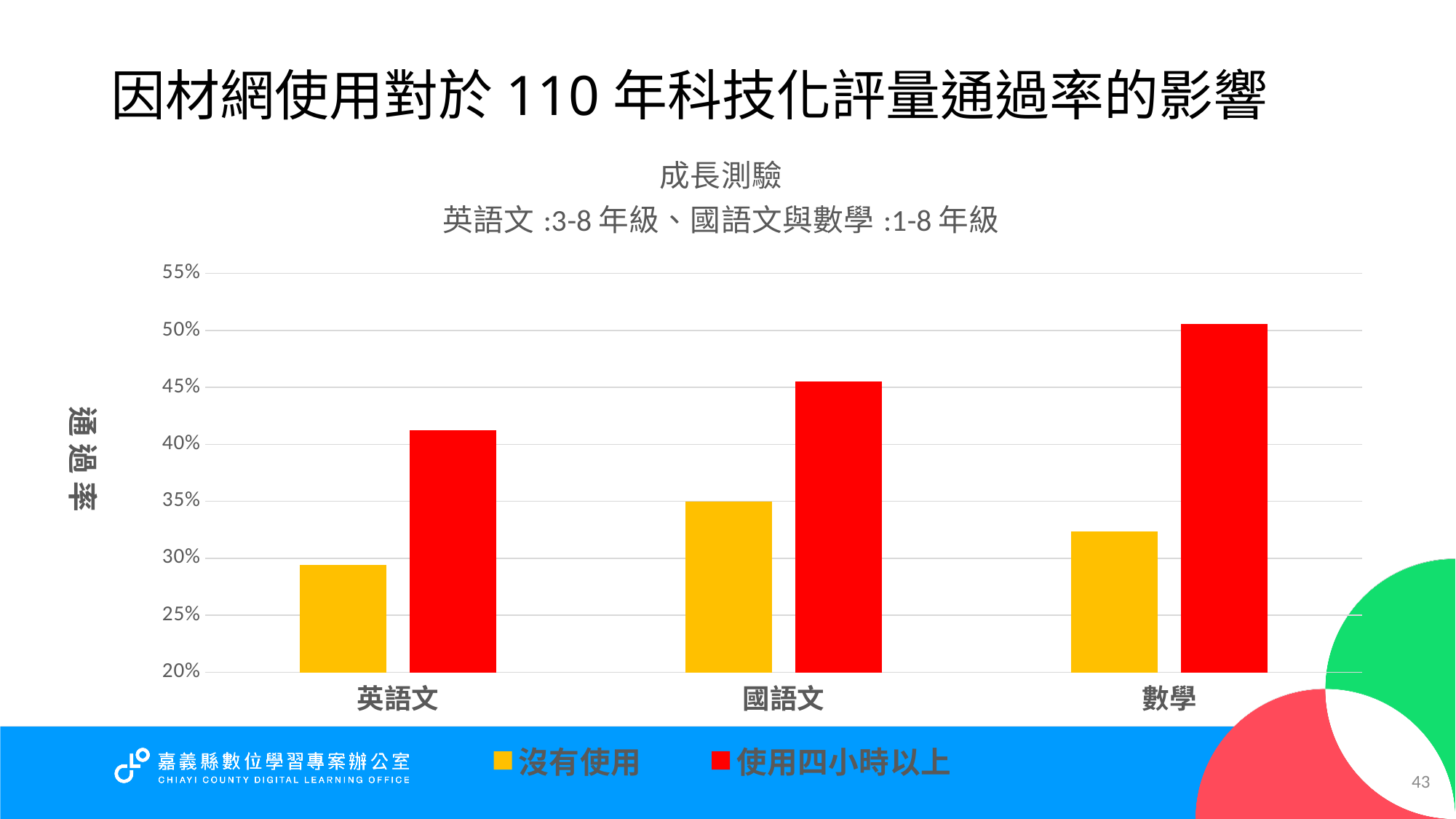
What label is shown on the y axis of the chart? 通過率 Is the 使用四小時以上 value for 數學 greater or less than 45%? greater Which is larger: the 沒有使用 value for 國語文 or the 沒有使用 value for 數學? 國語文 Is the 沒有使用 value for 數學 greater or less than 30%? greater Is the 使用四小時以上 value for 英語文 greater or less than 40%? greater Which bar is the lowest in the chart? 英語文, 沒有使用 How many series does the legend list? 2 How many subject categories are shown on the x axis? 3 Which bar is the highest in the chart? 數學, 使用四小時以上 What kind of chart is shown on the slide? bar chart Among the 沒有使用 bars, which subject has the highest pass rate? 國語文